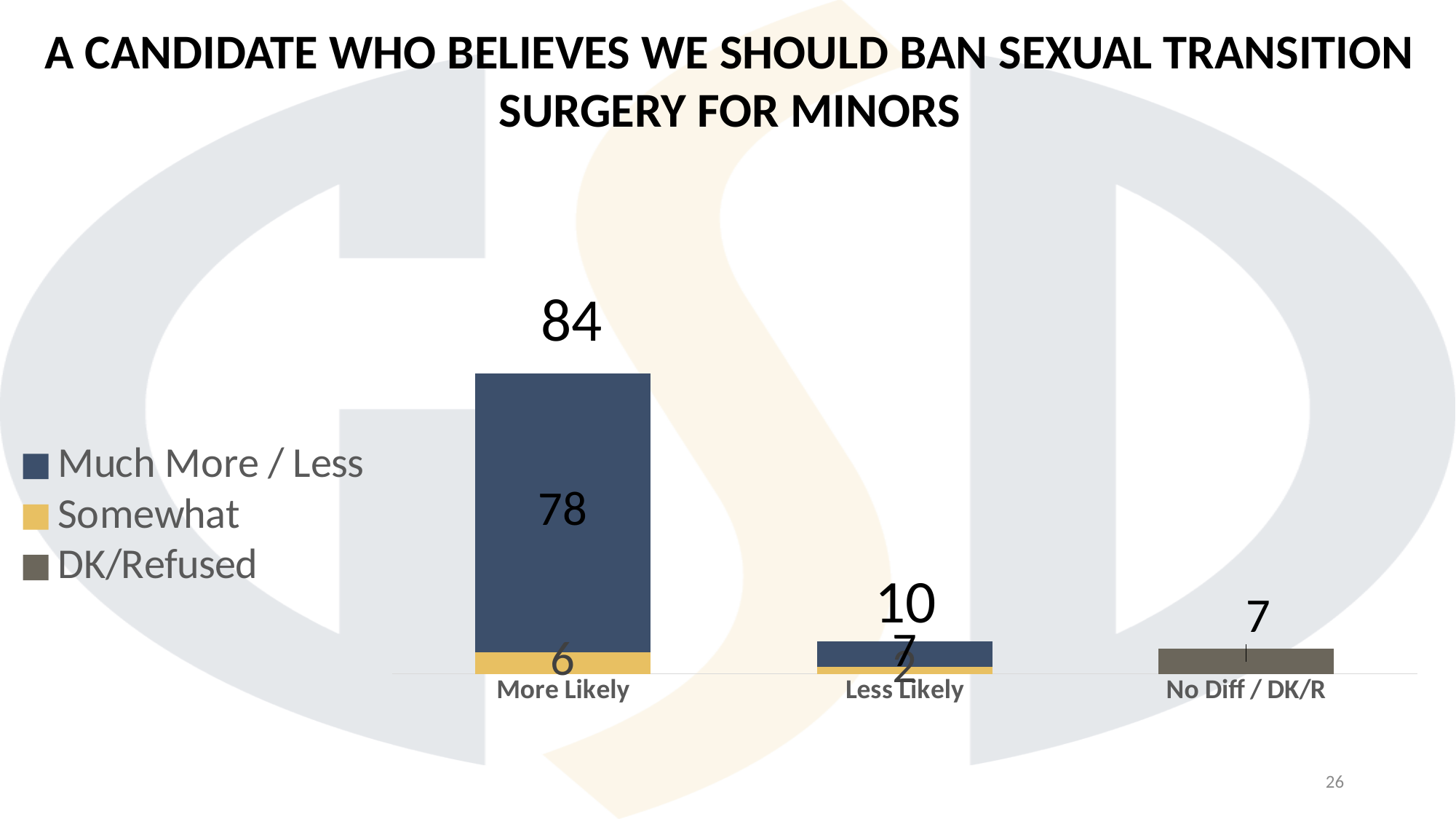
How many series does the legend list? 3 What is the value of the Somewhat segment for More Likely? 6 What is the value of the Much More / Less segment for More Likely? 78 What kind of chart is shown on the slide? Stacked bar chart What is the difference between the More Likely total and the Less Likely total? 74 Which is larger, the total for More Likely or the total for Less Likely? More Likely Which legend entry is shown in gold/yellow? Somewhat Which category has the highest total? More Likely What is the total of the stacked bar for More Likely? 84 What is the total of the stacked bar for Less Likely? 10 What is the value shown for No Diff / DK/R? 7 How many categories are shown on the x axis? 3